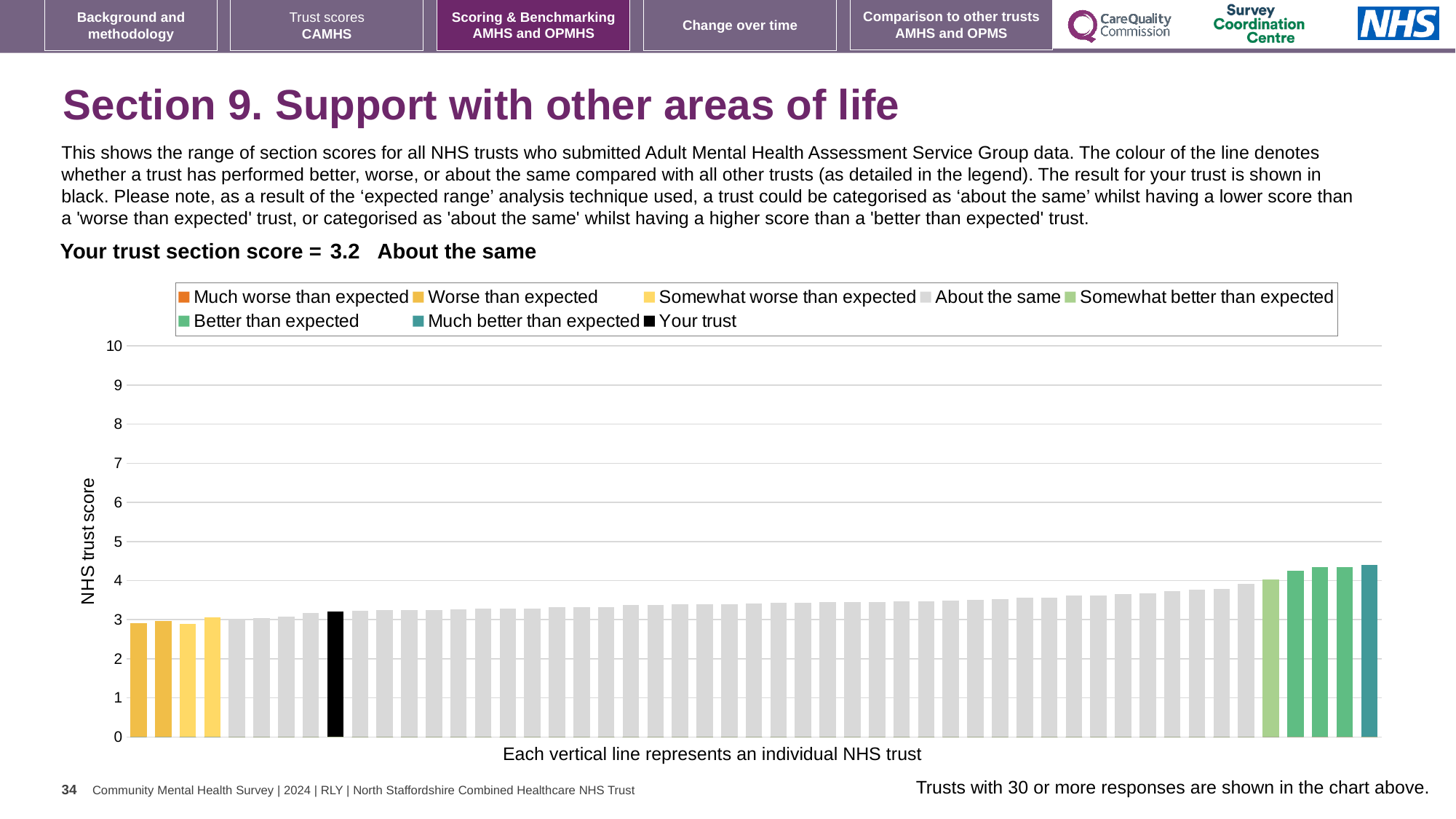
Do the bar values rise or fall from left to right across the chart? rise Is the value for your trust's bar greater or less than 3? greater Is the value of the tallest bar in the chart greater or less than 5? less How many bars are coloured as 'Worse than expected'? 2 What kind of chart is shown on the slide? bar chart Which legend category does the tallest bar in the chart belong to? Much better than expected How many entries does the chart legend list? 8 What is the section score for your trust shown on the slide? 3.2 Is the value of the leftmost bar in the chart greater or less than 4? less How many bars are coloured as 'Much better than expected'? 1 What is the title of the vertical axis of the chart? NHS trust score What colour is the bar representing your trust? black